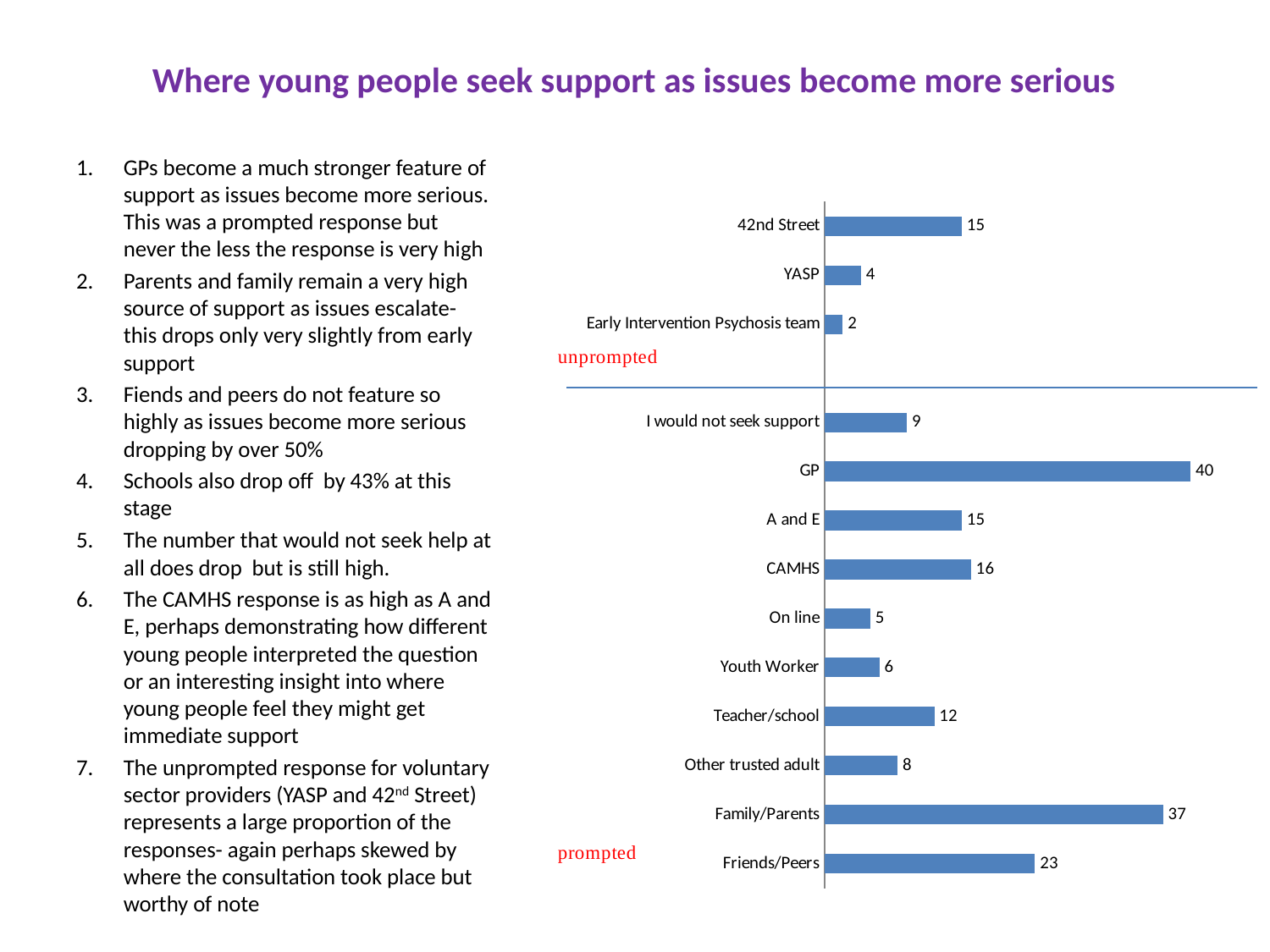
Which is larger, the value for CAMHS or the value for A and E? CAMHS Which is larger, the value for Youth Worker or the value for On line? Youth Worker What value is shown for I would not seek support? 9 Which category has the lowest value? Early Intervention Psychosis team What kind of chart is shown on the slide? Bar chart What is the difference between the values for Friends/Peers and Teacher/school? 11 What value is shown for 42nd Street? 15 What is the difference between the values for GP and Family/Parents? 3 What value is shown for Family/Parents? 37 What are the two red labels written beside the chart? unprompted and prompted What value is shown for GP? 40 Which category has the highest value? GP